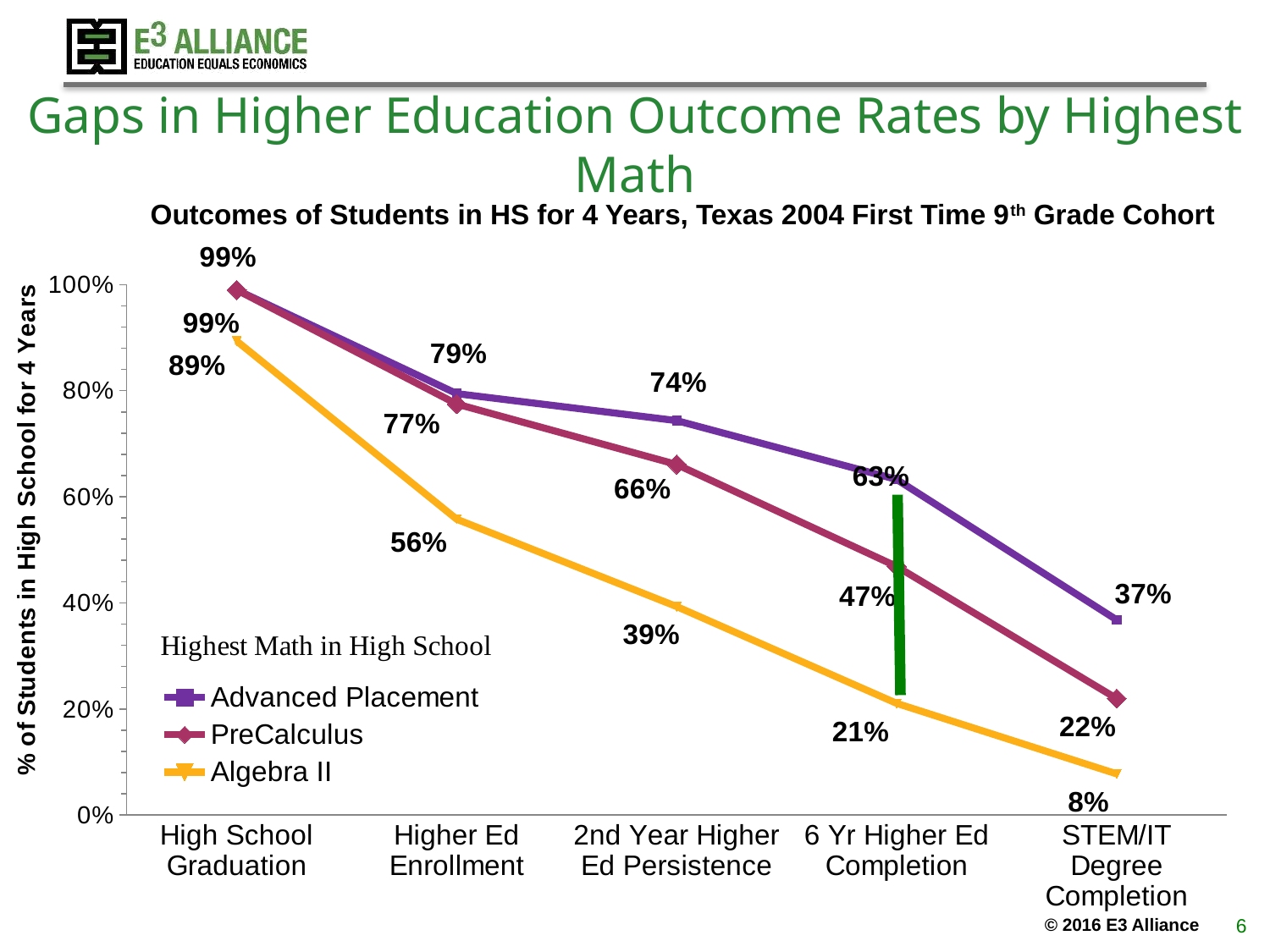
How many outcome categories are shown along the x axis? 5 How many series does the legend list? 3 Do the values for each series rise or fall from High School Graduation to STEM/IT Degree Completion? fall What kind of chart is shown on the slide? line chart What is the title of the legend? Highest Math in High School Which is larger at STEM/IT Degree Completion, the PreCalculus value or the Algebra II value? PreCalculus Which series has the lowest value at 2nd Year Higher Ed Persistence? Algebra II What is the difference between the Advanced Placement and PreCalculus values at 2nd Year Higher Ed Persistence? 8% What is the value for PreCalculus at 6 Yr Higher Ed Completion? 47% What is the value for Algebra II at Higher Ed Enrollment? 56% What is the difference between the Advanced Placement and Algebra II values at 6 Yr Higher Ed Completion? 42% What is the value for Advanced Placement at STEM/IT Degree Completion? 37%